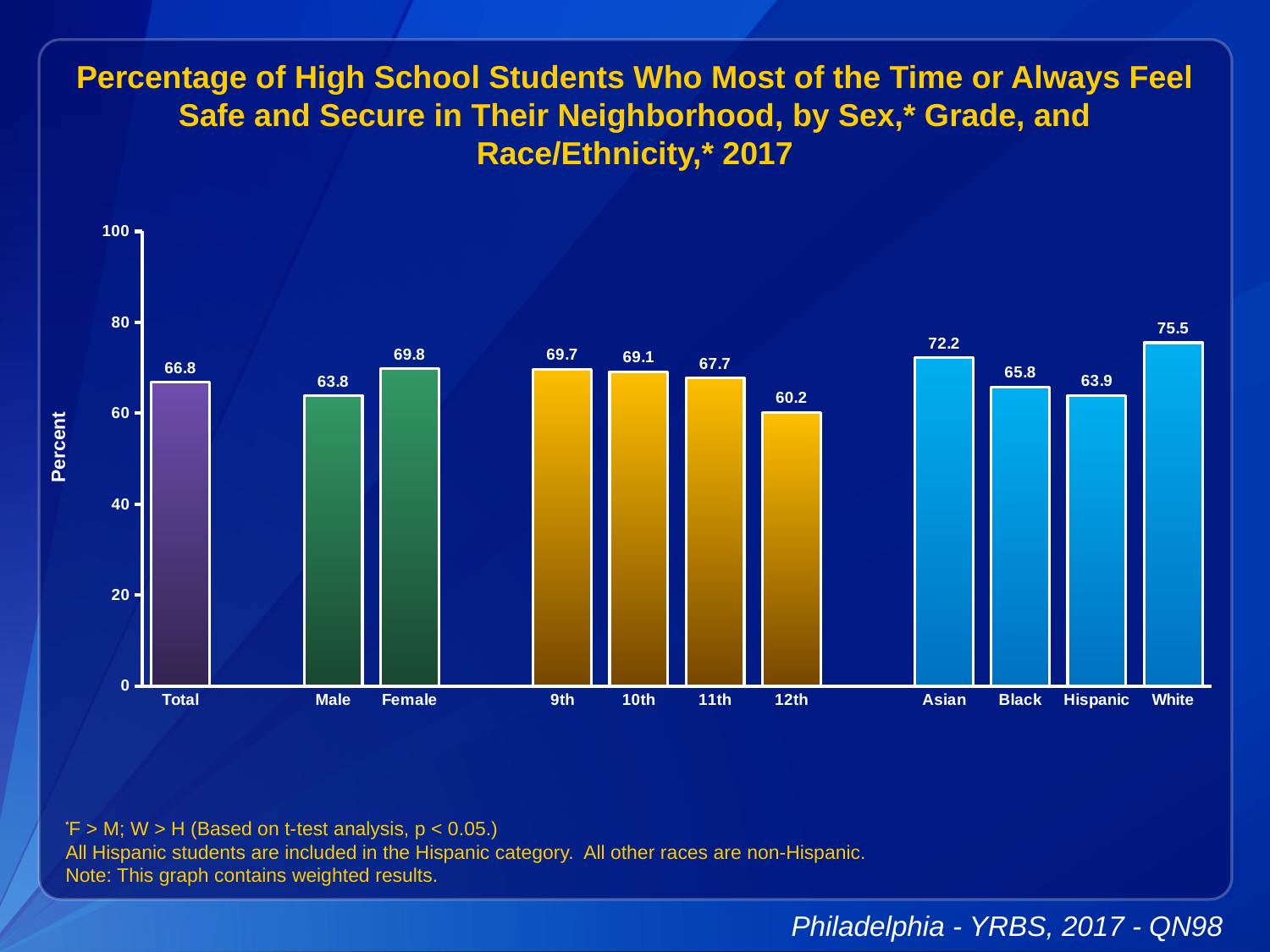
Which is larger, the value for Asian or the value for Black? Asian Is the value for Hispanic greater or less than 60? greater What kind of chart is shown? Bar chart What is the value for Total? 66.8 What is the value for 12th grade? 60.2 Do the values fall or rise from 9th grade to 12th grade? Fall Which category has the highest value? White Which category has the lowest value? 12th What is the value for Asian? 72.2 What is the difference between the Female and Male values? 6.0 What is the value for Female? 69.8 How many bars are shown in the chart? 11